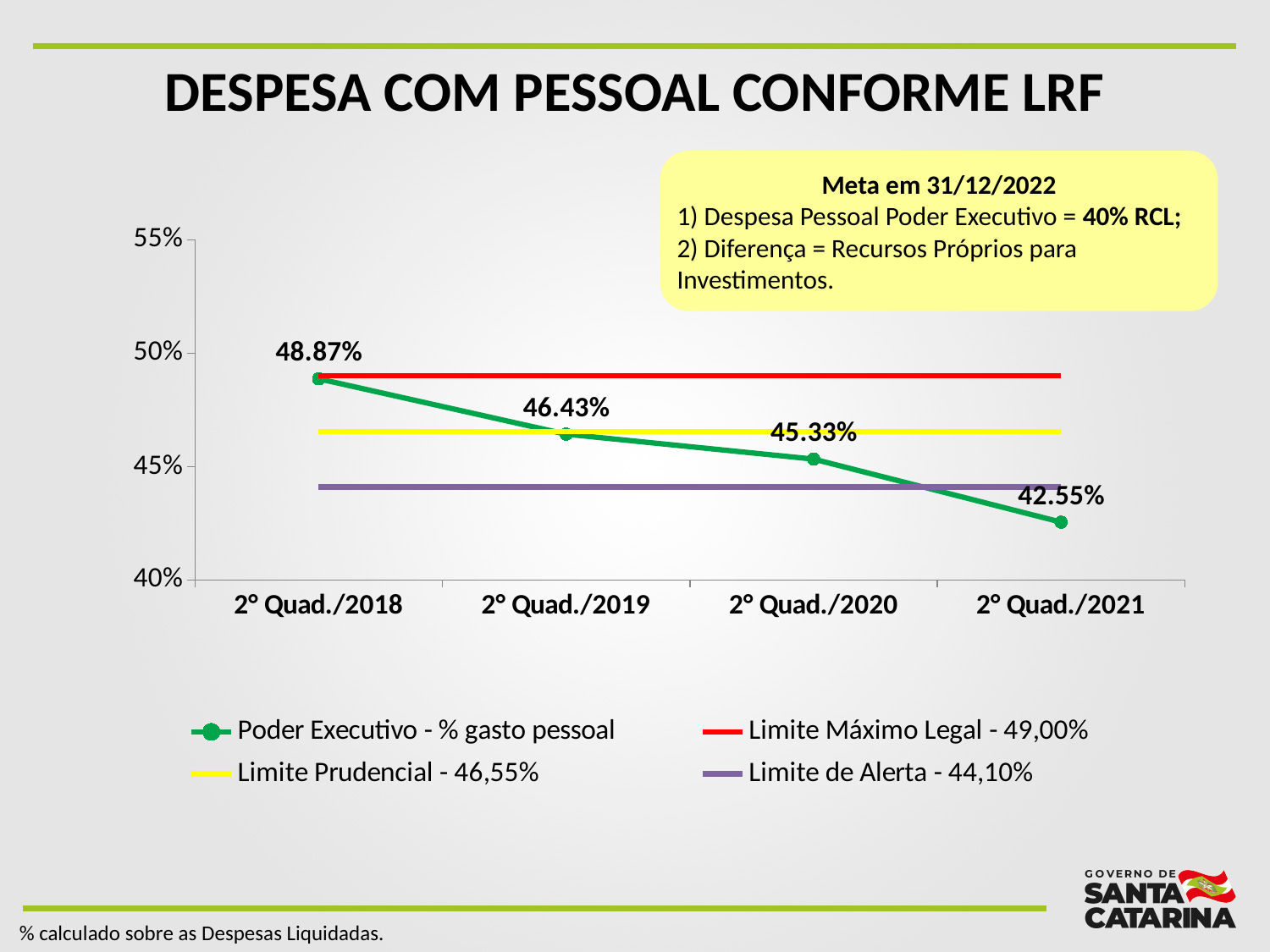
What is the value for Poder Executivo - % gasto pessoal in 2° Quad./2021? 42.55% How many series does the legend list? 4 Which is larger, the Poder Executivo - % gasto pessoal value for 2° Quad./2019 or for 2° Quad./2020? 2° Quad./2019 What is the value for Poder Executivo - % gasto pessoal in 2° Quad./2020? 45.33% In which period is Poder Executivo - % gasto pessoal highest? 2° Quad./2018 What is the value for Poder Executivo - % gasto pessoal in 2° Quad./2018? 48.87% How many periods are shown on the x axis? 4 Is the value for Poder Executivo - % gasto pessoal in 2° Quad./2021 greater or less than 45%? less What is the difference between the Poder Executivo - % gasto pessoal values for 2° Quad./2018 and 2° Quad./2021? 6.32% Does Poder Executivo - % gasto pessoal rise or fall from 2° Quad./2018 to 2° Quad./2021? fall In which period is Poder Executivo - % gasto pessoal lowest? 2° Quad./2021 What kind of chart is shown on the slide? line chart